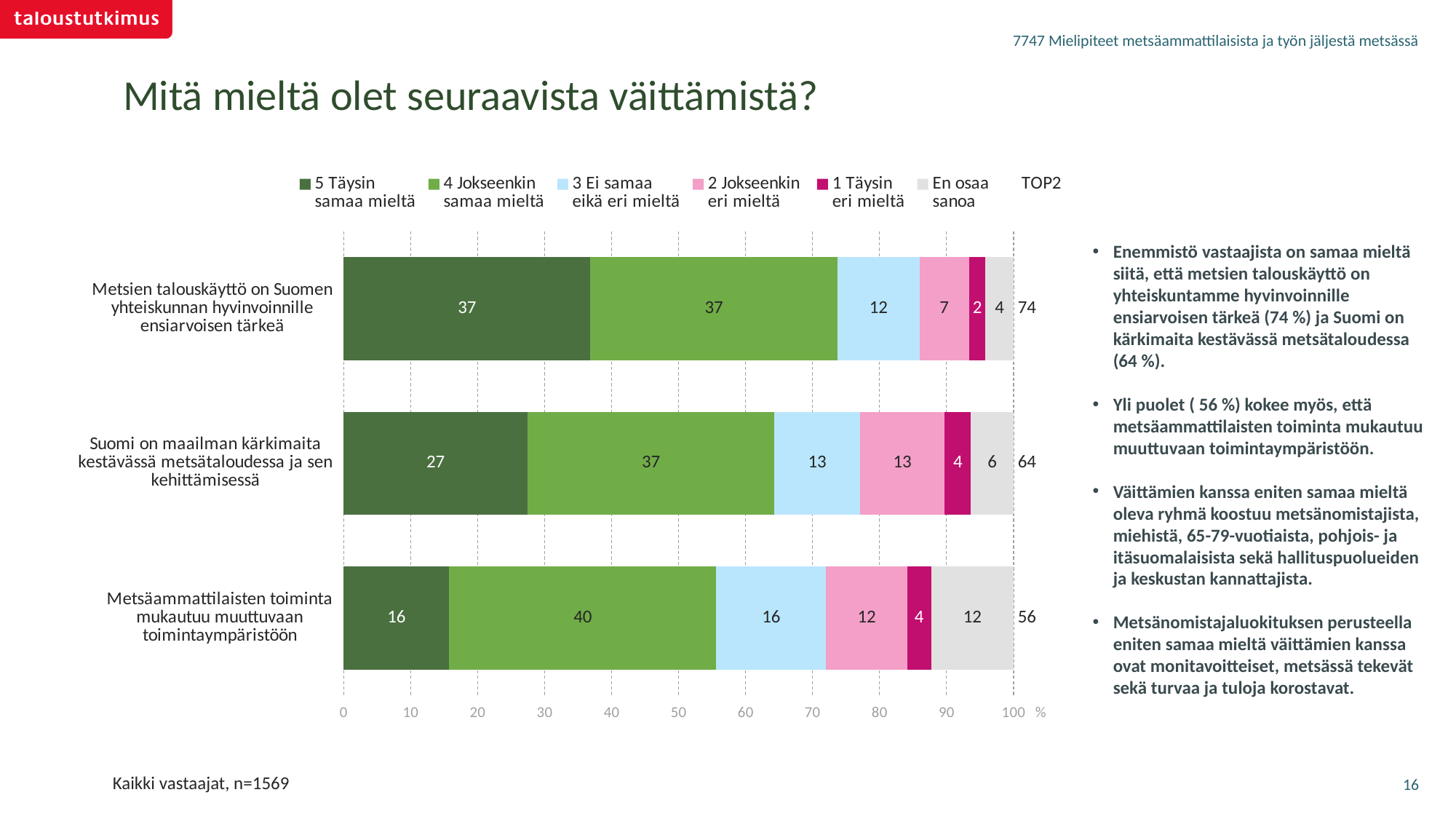
What is the difference between the TOP2 values of 'Metsien talouskäyttö on Suomen yhteiskunnan hyvinvoinnille ensiarvoisen tärkeä' and 'Suomi on maailman kärkimaita kestävässä metsätaloudessa ja sen kehittämisessä'? 10 What kind of chart is shown on the slide? Stacked bar chart Which is larger: the '2 Jokseenkin eri mieltä' value for 'Suomi on maailman kärkimaita kestävässä metsätaloudessa ja sen kehittämisessä' or for 'Metsien talouskäyttö on Suomen yhteiskunnan hyvinvoinnille ensiarvoisen tärkeä'? Suomi on maailman kärkimaita kestävässä metsätaloudessa ja sen kehittämisessä How many statements (categories) are plotted in the chart? 3 What is the value for '5 Täysin samaa mieltä' for the statement 'Metsien talouskäyttö on Suomen yhteiskunnan hyvinvoinnille ensiarvoisen tärkeä'? 37 Which statement has the lowest TOP2 value? Metsäammattilaisten toiminta mukautuu muuttuvaan toimintaympäristöön What is the TOP2 value for the statement 'Suomi on maailman kärkimaita kestävässä metsätaloudessa ja sen kehittämisessä'? 64 What is the value for '4 Jokseenkin samaa mieltä' for the statement 'Metsäammattilaisten toiminta mukautuu muuttuvaan toimintaympäristöön'? 40 What is the 'En osaa sanoa' value for the statement 'Metsäammattilaisten toiminta mukautuu muuttuvaan toimintaympäristöön'? 12 Which statement has the highest '5 Täysin samaa mieltä' value? Metsien talouskäyttö on Suomen yhteiskunnan hyvinvoinnille ensiarvoisen tärkeä What is the sample size stated below the chart? n=1569 How many response categories does the chart legend list (excluding the TOP2 label)? 6